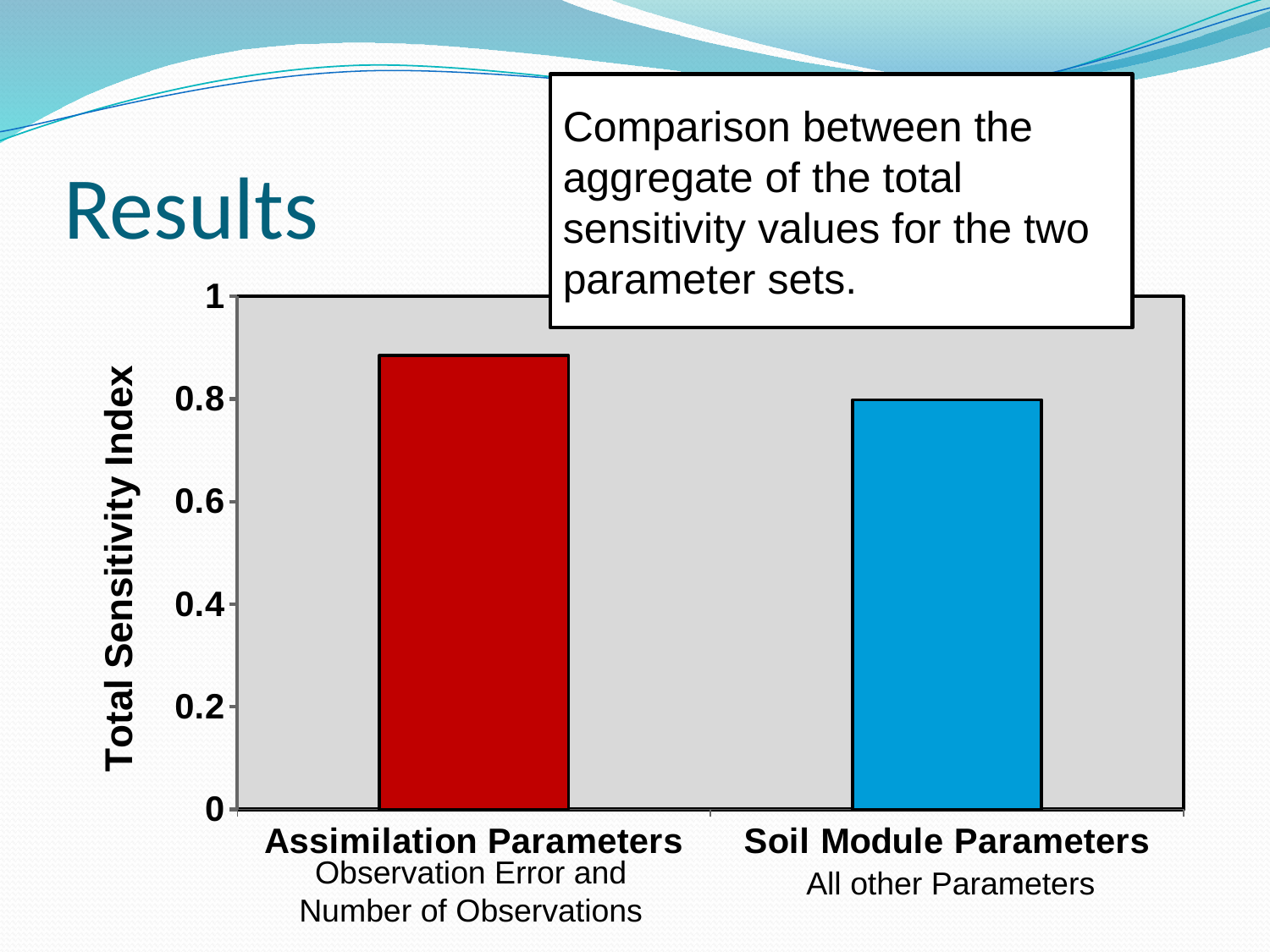
What colour is the bar for Soil Module Parameters? blue Is the value for Assimilation Parameters greater or less than 1? less What kind of chart is shown on the slide? bar chart Which category has the lowest Total Sensitivity Index? Soil Module Parameters Which category has the highest Total Sensitivity Index? Assimilation Parameters How many categories (bars) are plotted in the chart? 2 What is the label of the vertical axis of the chart? Total Sensitivity Index Is the value for Soil Module Parameters greater or less than 0.6? greater Is the value for Soil Module Parameters greater or less than 1? less Which is larger, the Total Sensitivity Index for Assimilation Parameters or for Soil Module Parameters? Assimilation Parameters